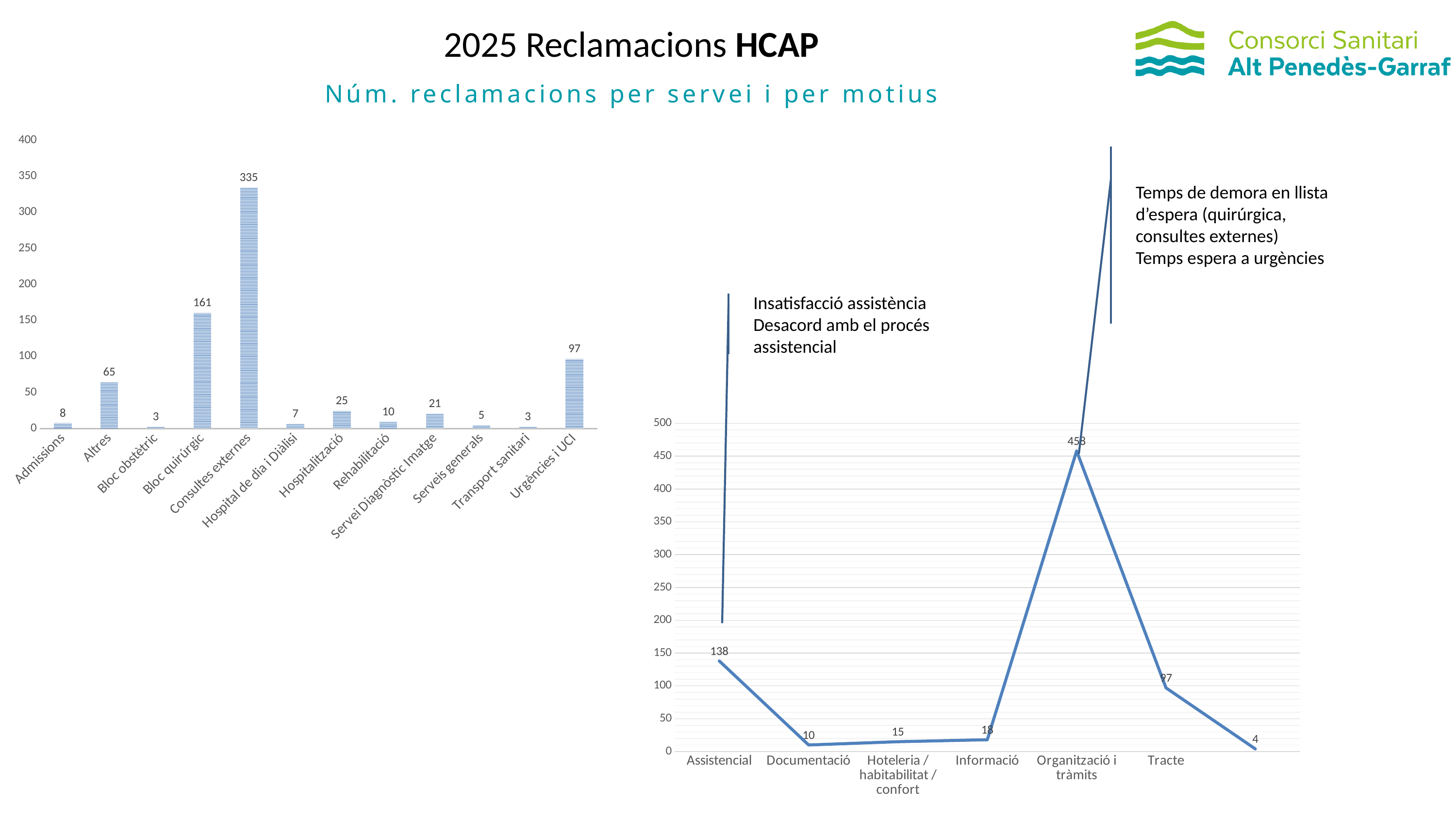
On the right line chart, what is the value for Assistencial? 138 On the left bar chart, what is the difference between Consultes externes and Bloc quirúrgic? 174 What kind of chart is the chart on the left of the slide? Bar chart On the right line chart, what is the value for Organització i tràmits? 458 On the left bar chart, which service has the highest number of reclamacions? Consultes externes On the right line chart, what is the difference between Informació and Documentació? 8 What kind of chart is the chart on the right of the slide? Line chart On the right line chart, which motiu has the highest value? Organització i tràmits On the left bar chart, which is larger: Altres or Hospitalització? Altres On the left bar chart, what is the value for Urgències i UCI? 97 How many service categories are shown on the left bar chart? 12 On the left bar chart, how many reclamacions are shown for Consultes externes? 335